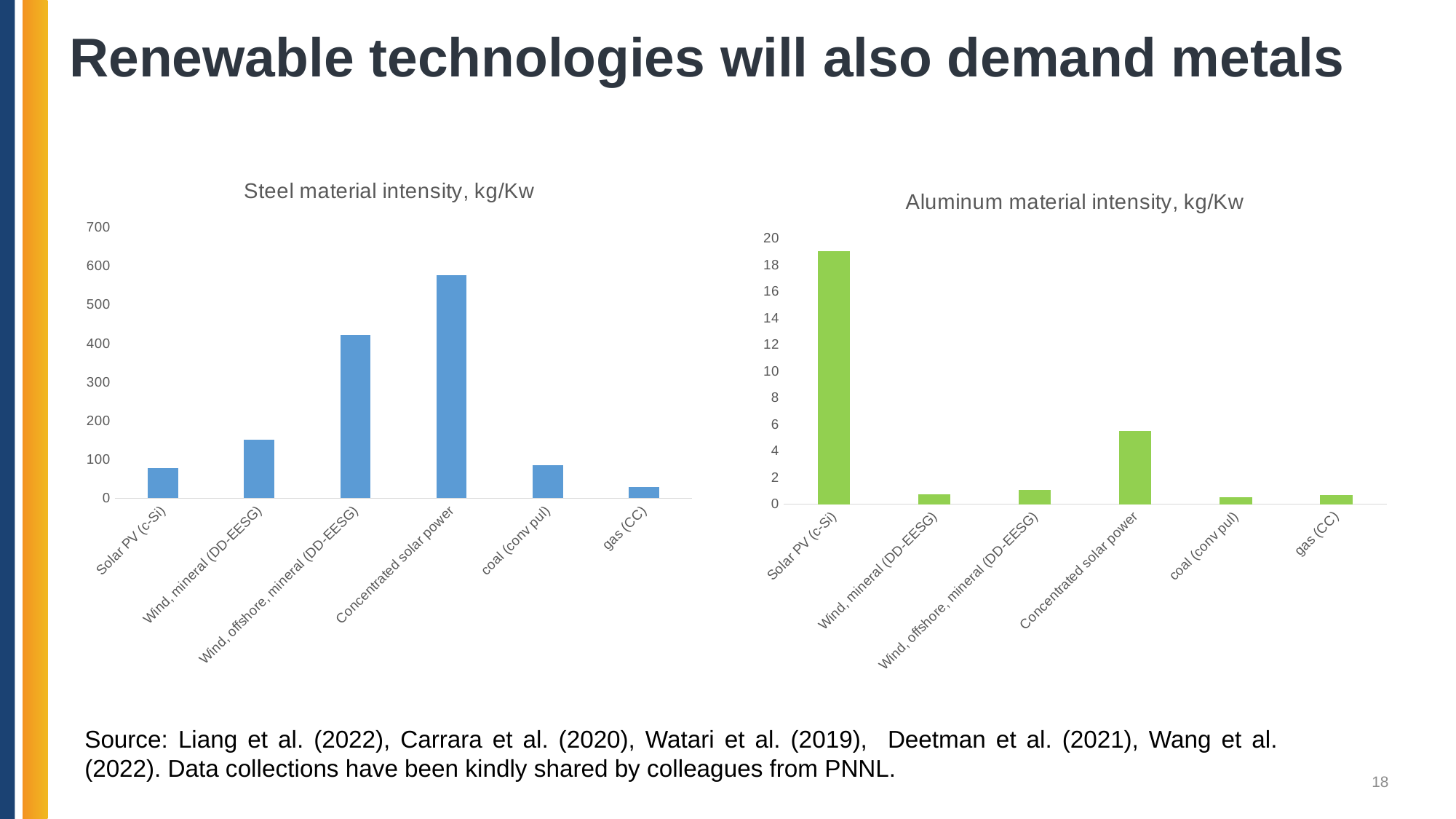
In the 'Steel material intensity, kg/Kw' chart, which is larger: Wind, mineral (DD-EESG) or coal (conv pul)? Wind, mineral (DD-EESG) In the 'Aluminum material intensity, kg/Kw' chart, which is larger: Concentrated solar power or Wind, offshore, mineral (DD-EESG)? Concentrated solar power In the 'Aluminum material intensity, kg/Kw' chart, which category has the highest value? Solar PV (c-Si) How many categories are shown in the 'Steel material intensity, kg/Kw' chart? 6 In the 'Steel material intensity, kg/Kw' chart, which category has the highest value? Concentrated solar power In the 'Steel material intensity, kg/Kw' chart, is the value for Concentrated solar power greater or less than 500? greater In the 'Steel material intensity, kg/Kw' chart, is the value for Wind, offshore, mineral (DD-EESG) greater or less than 400? greater What type of chart is the 'Aluminum material intensity, kg/Kw' chart? Bar chart In the 'Aluminum material intensity, kg/Kw' chart, is the value for Concentrated solar power greater or less than 4? greater In the 'Steel material intensity, kg/Kw' chart, which category has the lowest value? gas (CC)